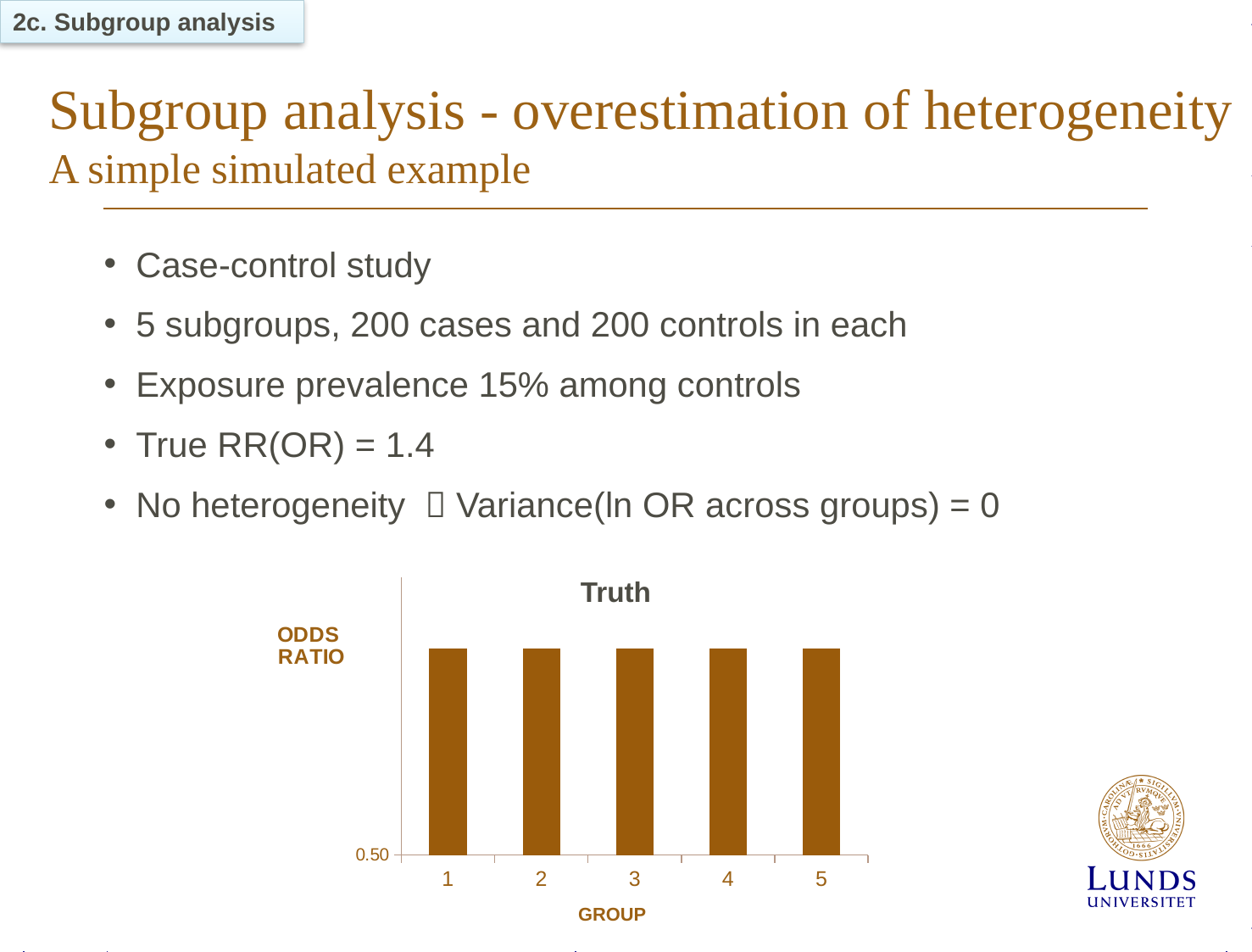
Do the bar heights rise, fall, or stay the same from group 1 to group 5? stay the same Is the value for group 5 greater or less than 0.50? greater What is the label of the y axis of the chart? ODDS RATIO What is the title of the chart? Truth Is the value for group 3 greater or less than 0.50? greater How many groups are plotted on the x axis of the chart? 5 Is the value for group 1 greater or less than 0.50? greater What kind of chart is shown on the slide? bar chart